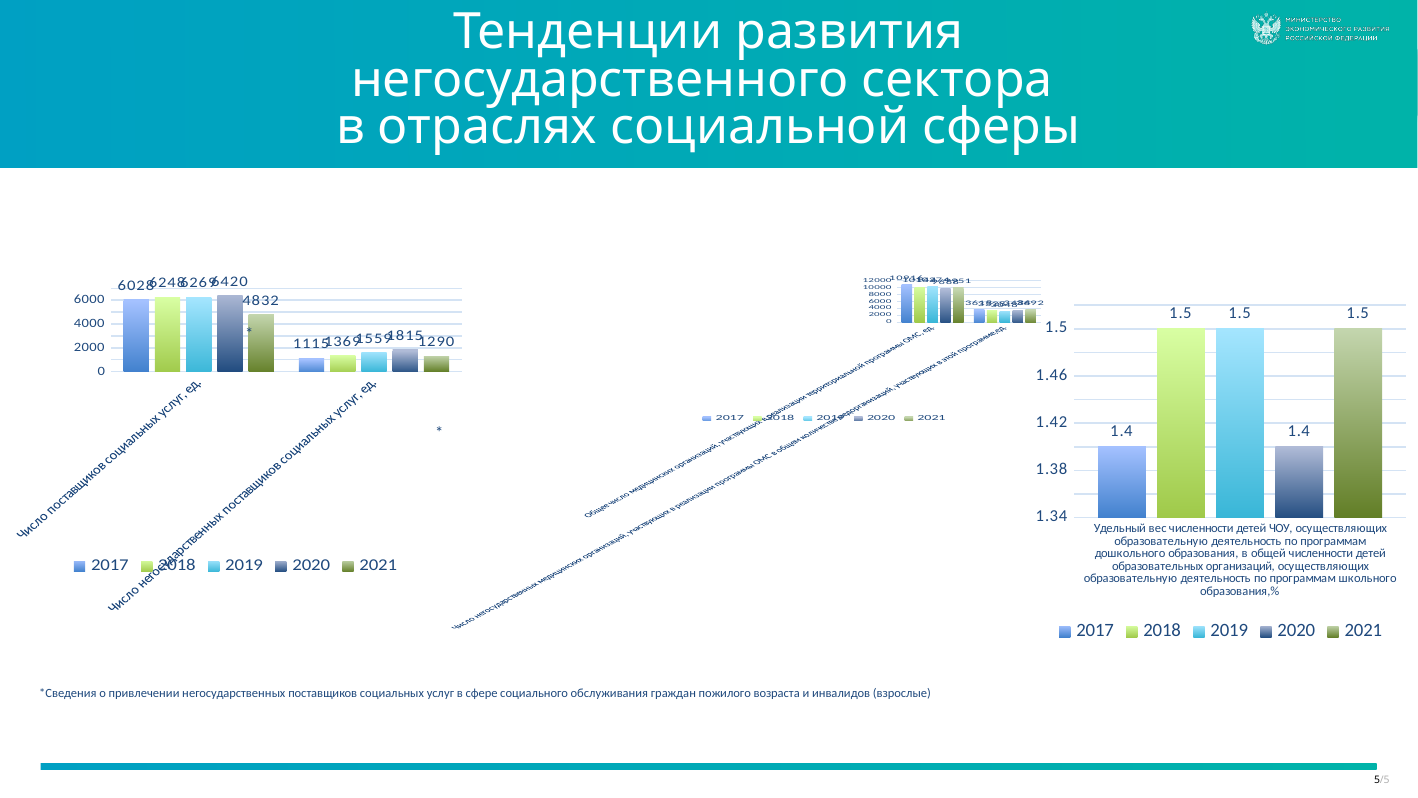
In the left chart, which year has the highest value in the category "Число поставщиков социальных услуг, ед."? 2020 In the right chart, what is the value for 2020? 1.4 In the left chart, what is the value for 2017 in the category "Число поставщиков социальных услуг, ед."? 6028 In the left chart, what is the difference between the 2020 and 2021 values in the category "Число поставщиков социальных услуг, ед."? 1588 In the left chart, what is the value for 2021 in the category "Число поставщиков социальных услуг, ед."? 4832 In the left chart, which year has the lowest value in the category "Число негосударственных поставщиков социальных услуг, ед."? 2017 What kind of chart is the right chart? bar chart In the right chart, what is the value for 2018? 1.5 In the right chart, which is larger: the value for 2017 or the value for 2021? 2021 In the left chart, what is the value for 2020 in the category "Число негосударственных поставщиков социальных услуг, ед."? 1815 In the left chart, which is larger: the 2019 value or the 2021 value in the category "Число негосударственных поставщиков социальных услуг, ед."? 2019 How many series does the legend of the left chart list? 5